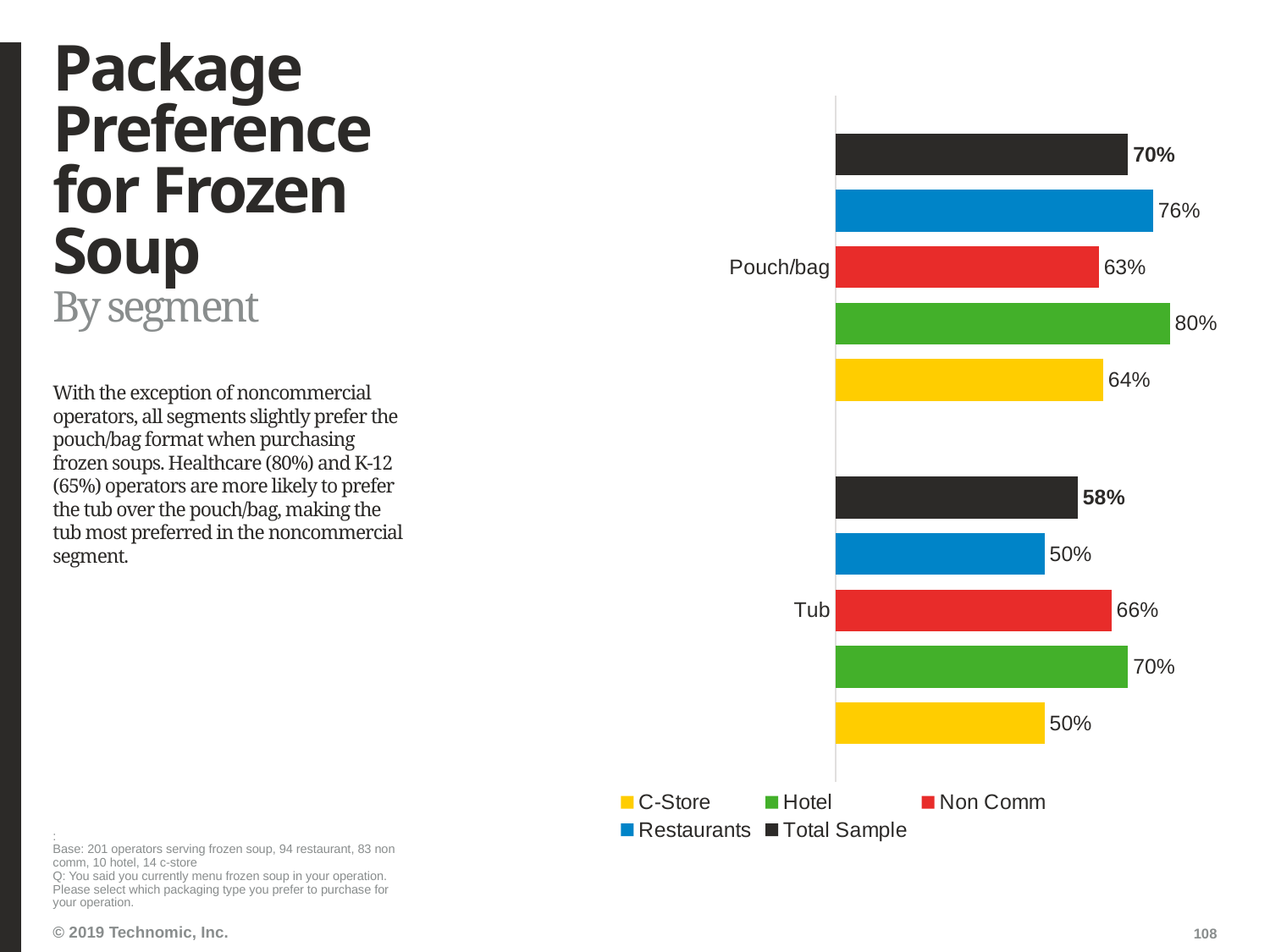
What is the Restaurants value for Tub? 50% What is the Total Sample value for Tub? 58% Which segment has the highest value for Pouch/bag? Hotel Which is larger for Non Comm: the Pouch/bag value or the Tub value? Tub Which segment has the highest value for Tub? Hotel Which segment has the lowest value for Pouch/bag? Non Comm What is the Non Comm value for Pouch/bag? 63% What is the difference between the Restaurants values for Pouch/bag and Tub? 26% What is the Hotel value for Pouch/bag? 80% What kind of chart is shown on the slide? Bar chart How many series does the legend list? 5 How many package categories are shown on the chart? 2